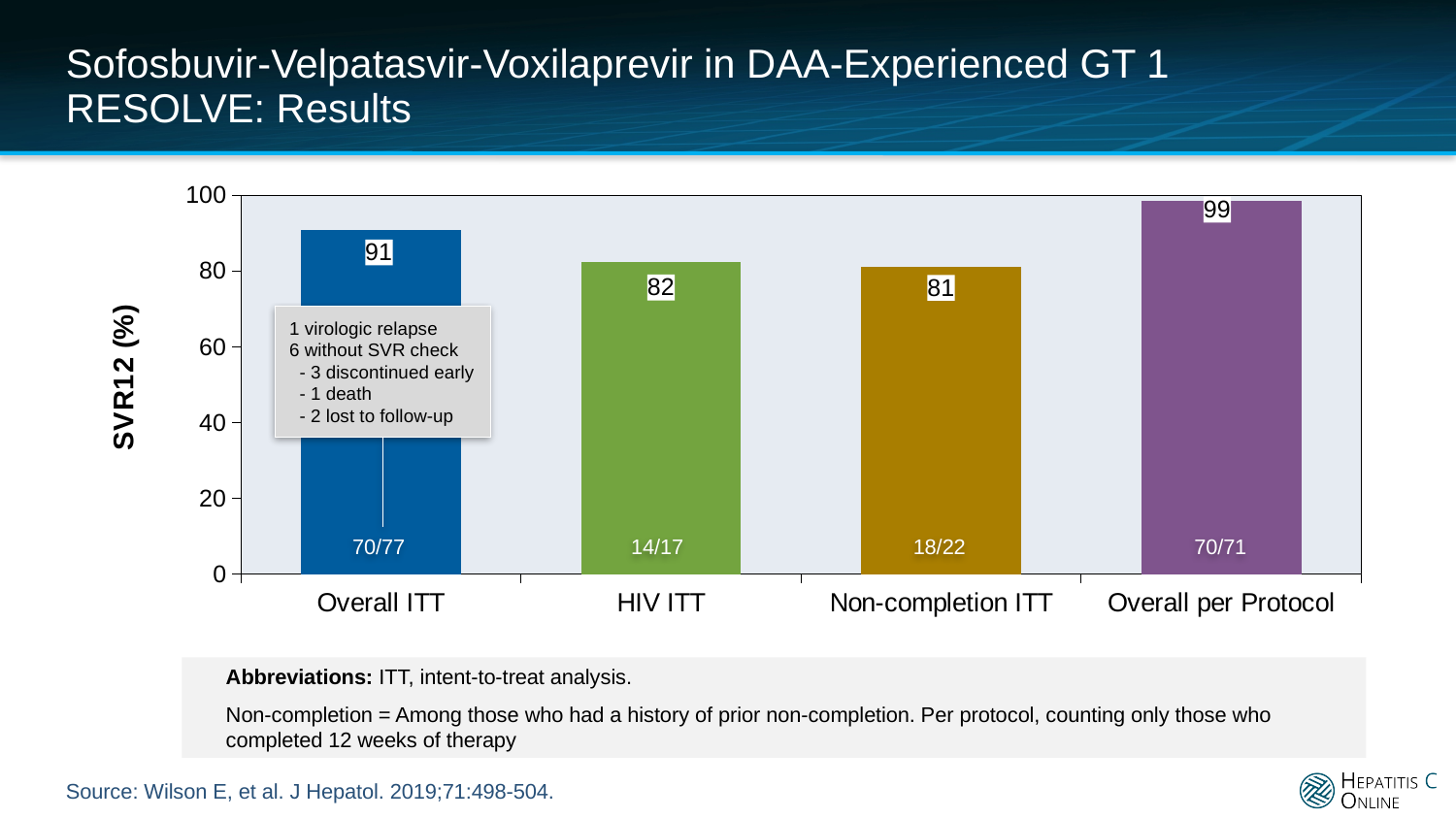
Which is larger, the SVR12 value for Overall ITT or for HIV ITT? Overall ITT What is the difference between the SVR12 values for Overall per Protocol and Overall ITT? 8 What is the label of the y axis? SVR12 (%) Which category has the highest SVR12 value? Overall per Protocol What is the SVR12 value for Overall per Protocol? 99 What kind of chart is shown on the slide? Bar chart What is the SVR12 value for Overall ITT? 91 How many categories are shown on the x axis? 4 What fraction is printed at the base of the HIV ITT bar? 14/17 What is the SVR12 value for Non-completion ITT? 81 What is the SVR12 value for HIV ITT? 82 Which category has the lowest SVR12 value? Non-completion ITT